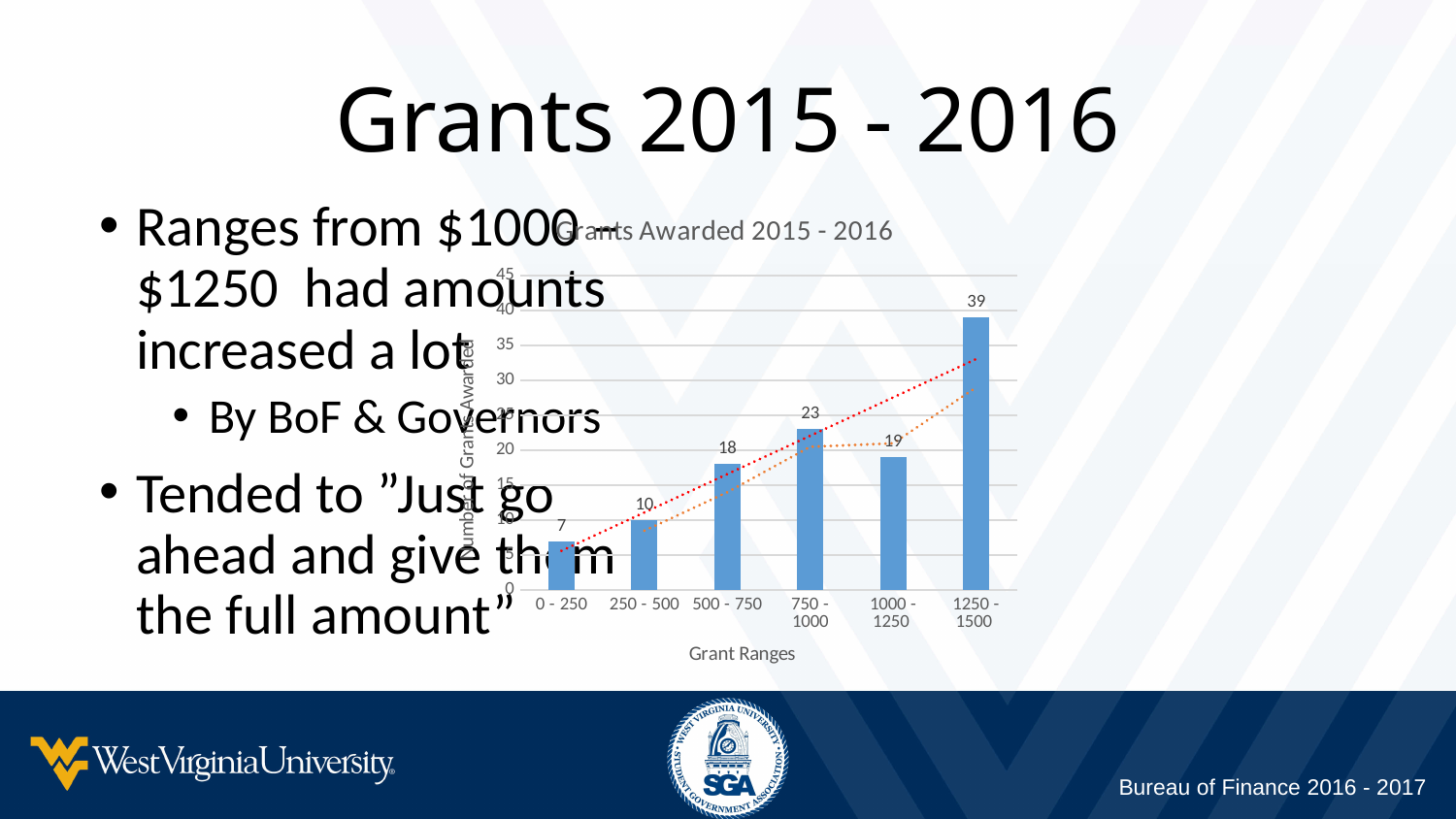
Which grant range has the highest number of grants awarded? 1250 - 1500 Which range had more grants awarded, 750 - 1000 or 1000 - 1250? 750 - 1000 What is the title of the chart? Grants Awarded 2015 - 2016 How many grants were awarded in the 750 - 1000 range? 23 How many grants were awarded in the 0 - 250 range? 7 What is the label of the x axis? Grant Ranges How many grants were awarded in the 1000 - 1250 range? 19 What is the difference between the number of grants awarded in the 1250 - 1500 range and the 1000 - 1250 range? 20 What kind of chart is shown on the slide? Bar chart How many grants were awarded in the 1250 - 1500 range? 39 How many grant ranges are shown on the x axis? 6 Which grant range has the lowest number of grants awarded? 0 - 250